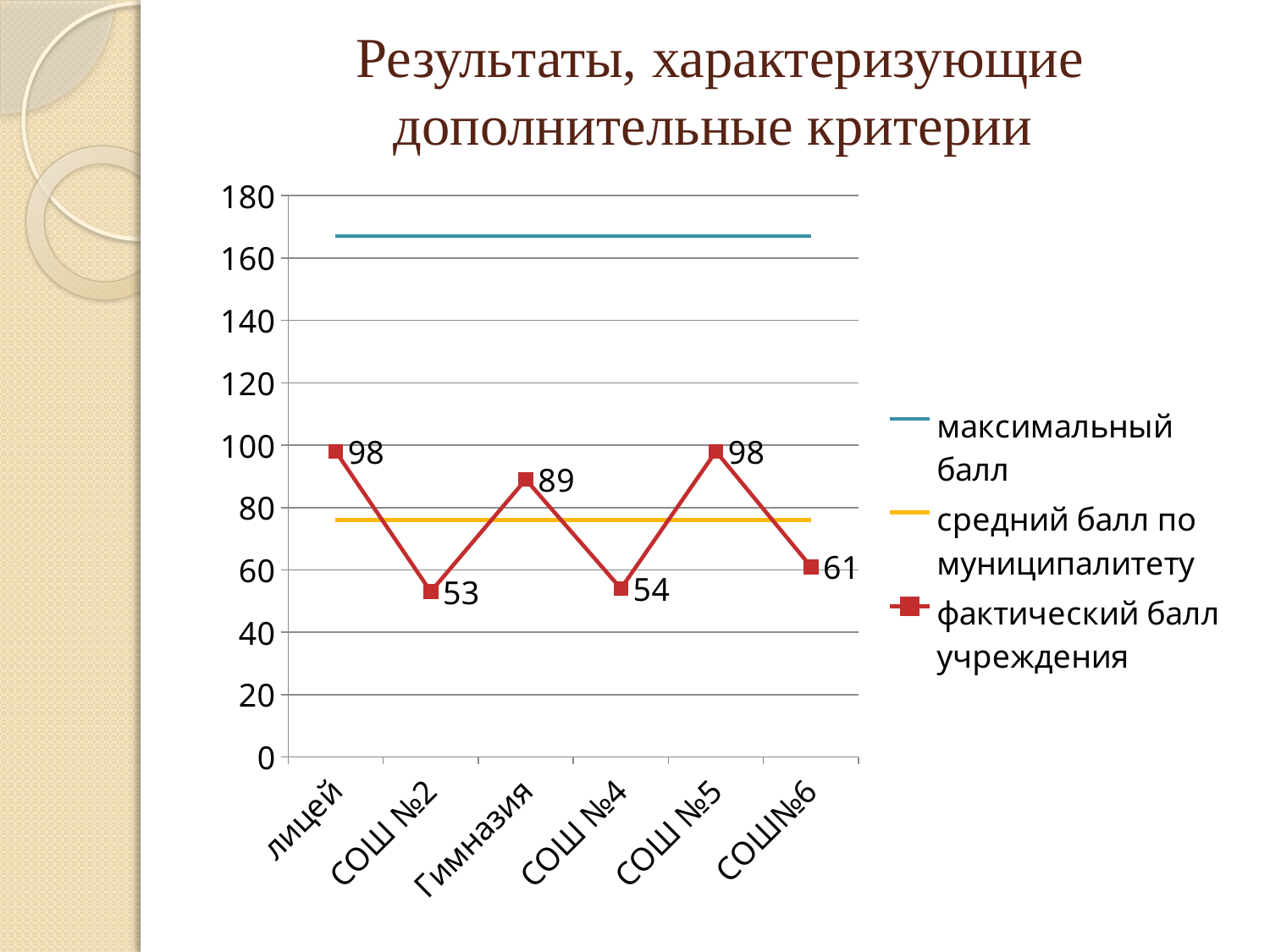
What is the difference between the фактический балл учреждения for лицей and for СОШ №2? 45 What is the фактический балл учреждения for Гимназия? 89 Is the value of the средний балл по муниципалитету line greater or less than 80? less Is the value of the максимальный балл line greater or less than 160? greater What is the фактический балл учреждения for СОШ №4? 54 What is the фактический балл учреждения for лицей? 98 Which has a higher фактический балл учреждения, Гимназия or СОШ№6? Гимназия How many series does the legend list? 3 Which institution has the lowest фактический балл учреждения? СОШ №2 What kind of chart is shown on the slide? line chart What is the фактический балл учреждения for СОШ№6? 61 How many institutions are shown on the x axis? 6